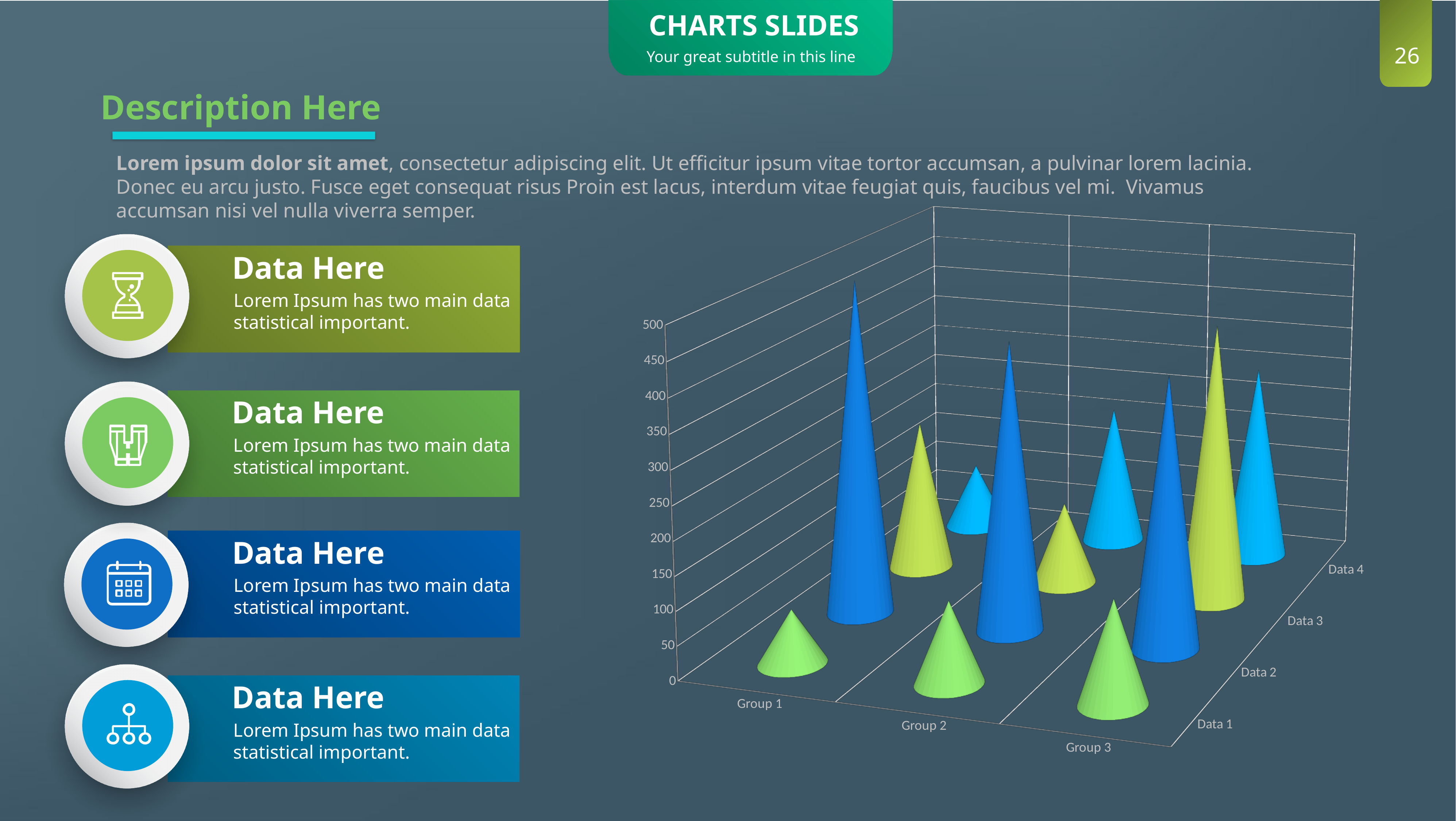
Is the value for Data 1 in Group 2 greater or less than 250? less Is the value for Data 1 in Group 1 greater or less than 200? less How many groups are labelled along the horizontal axis of the chart? 3 What is the highest value shown on the chart's vertical axis? 500 What kind of chart is shown on the slide? bar chart In Group 2, which is larger: the value for Data 1 or the value for Data 2? Data 2 Is the value for Data 2 in Group 1 greater or less than 300? greater How many data series (Data 1 to Data 4) are labelled on the depth axis of the chart? 4 In Group 1, which is larger: the value for Data 1 or the value for Data 2? Data 2 What is the label of the first category on the chart's horizontal axis? Group 1